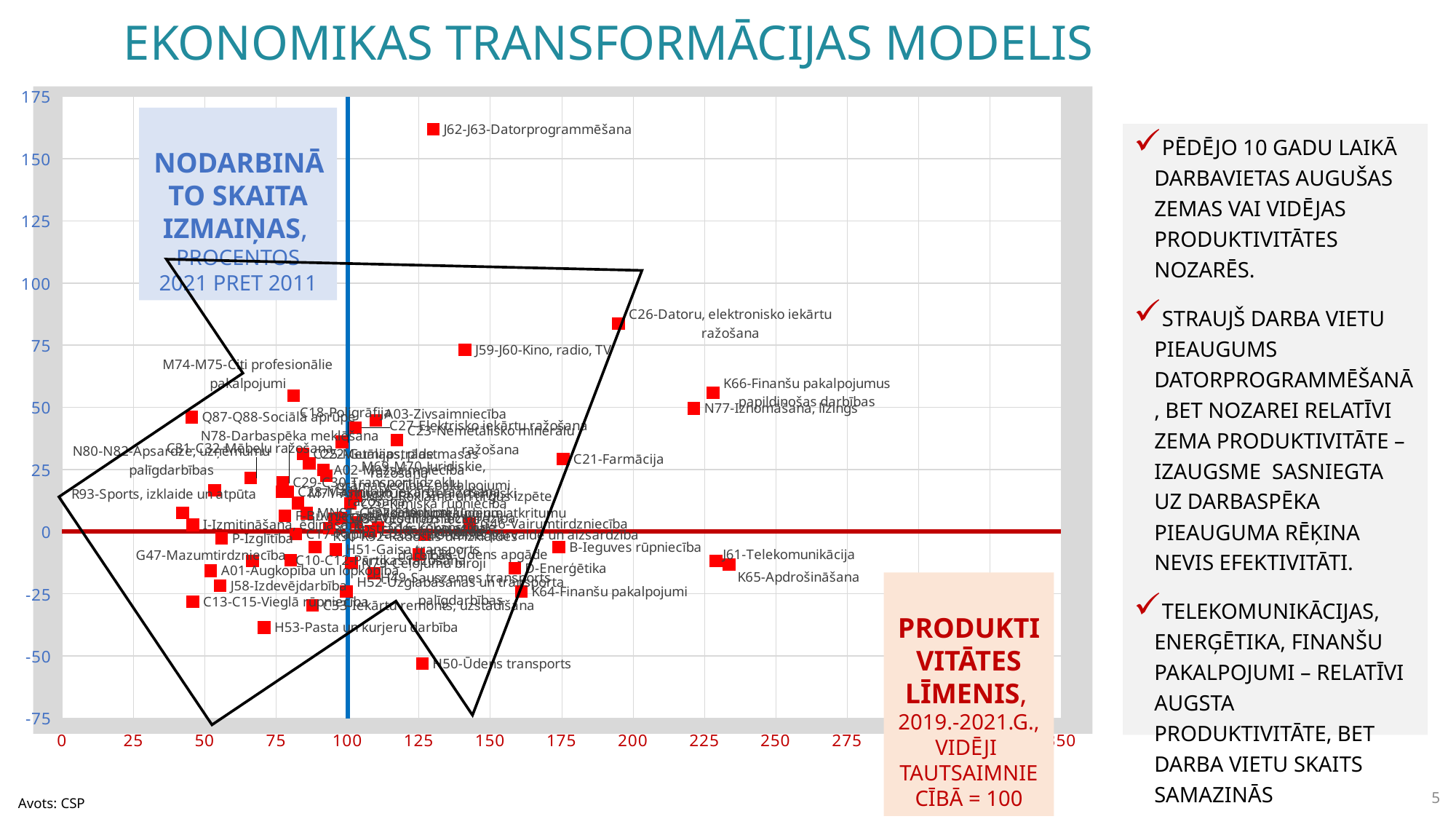
Is the vertical-axis value for J62-J63-Datorprogrammēšana greater or less than 150? greater Which labelled point has the lowest value on the vertical axis (employment change)? H50-Ūdens transports Is the horizontal-axis value for C26-Datoru, elektronisko iekārtu ražošana greater or less than 175? greater Is the vertical-axis value for H53-Pasta un kurjeru darbība greater or less than -25? less Which has the higher vertical-axis value, J62-J63-Datorprogrammēšana or C26-Datoru, elektronisko iekārtu ražošana? J62-J63-Datorprogrammēšana Which has the larger horizontal-axis value, C26-Datoru, elektronisko iekārtu ražošana or J59-J60-Kino, radio, TV? C26-Datoru, elektronisko iekārtu ražošana What kind of chart is shown on the slide? Scatter chart What is the title of the slide? EKONOMIKAS TRANSFORMĀCIJAS MODELIS Which labelled point has the highest value on the vertical axis (employment change)? J62-J63-Datorprogrammēšana